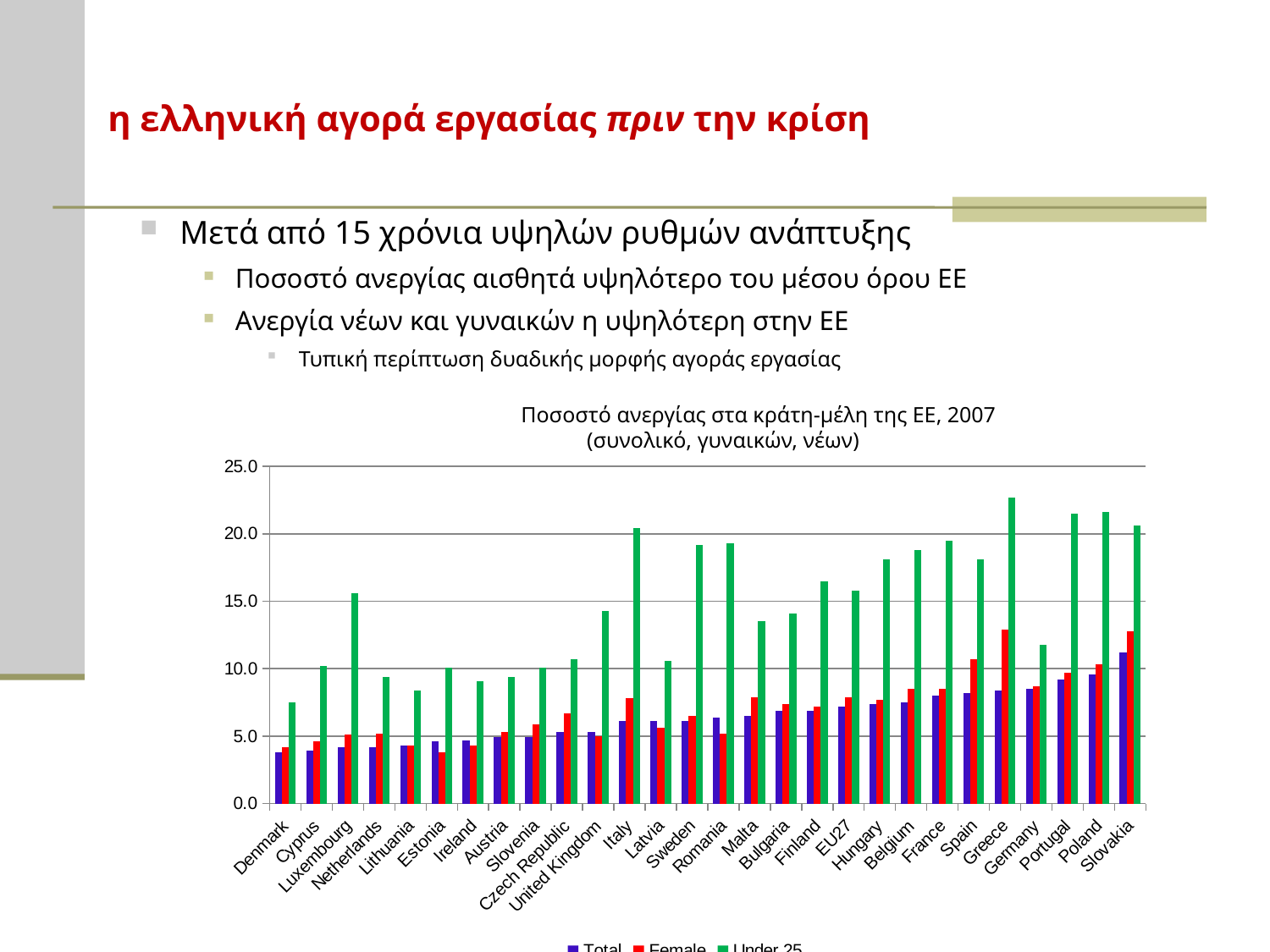
Which colour represents the Under 25 series in the chart? green Which category has the highest Under 25 value? Greece What kind of chart is shown on the slide? bar chart Is the Under 25 value for Spain greater or less than 15.0? greater Which category has the highest Total value? Slovakia How many series does the chart legend list? 3 Which is larger, the Under 25 value for Greece or the Under 25 value for Germany? Greece Is the Under 25 value for Denmark greater or less than 10.0? less How many countries/categories are shown on the x axis of the chart? 28 Is the Total value for Slovakia greater or less than 10.0? greater Do the Total values generally rise or fall moving from left to right along the x axis? rise